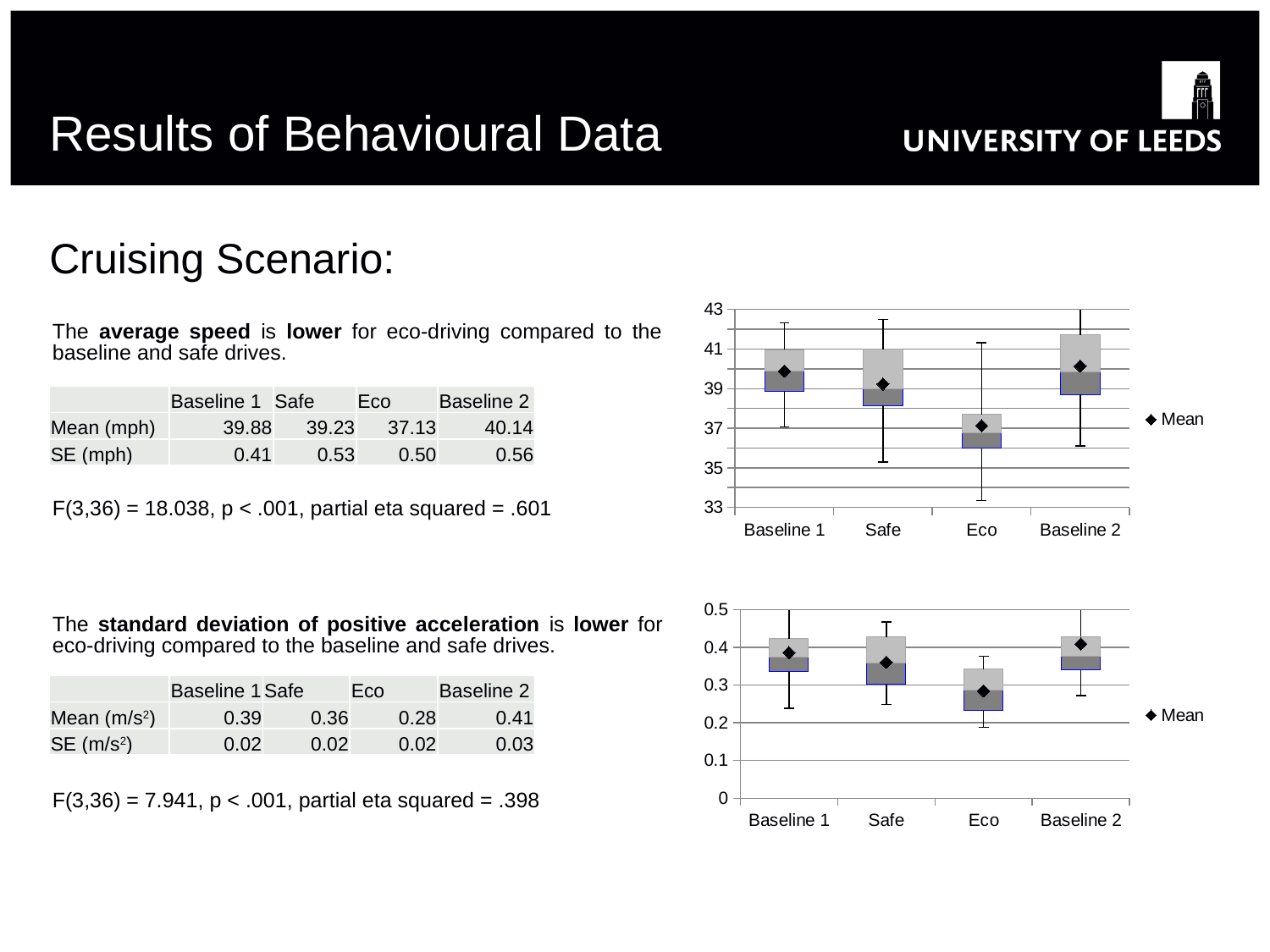
In the top chart, which category has the lowest mean? Eco In the bottom chart, which has the larger mean, Safe or Eco? Safe What is the mean speed (mph) for Eco plotted in the top chart, as given on the slide? 37.13 In the top chart, which has the larger mean, Baseline 1 or Eco? Baseline 1 In the bottom chart, which category has the lowest mean? Eco In the bottom chart, is the mean for Safe greater or less than 0.3? greater How many entries does the legend of the bottom chart list? 1 In the top chart, is the mean for Eco greater or less than 39? less How many categories are shown on the x axis of the top chart? 4 In the top chart, is the mean for Baseline 1 greater or less than 39? greater What is the legend entry shown next to the top chart? Mean